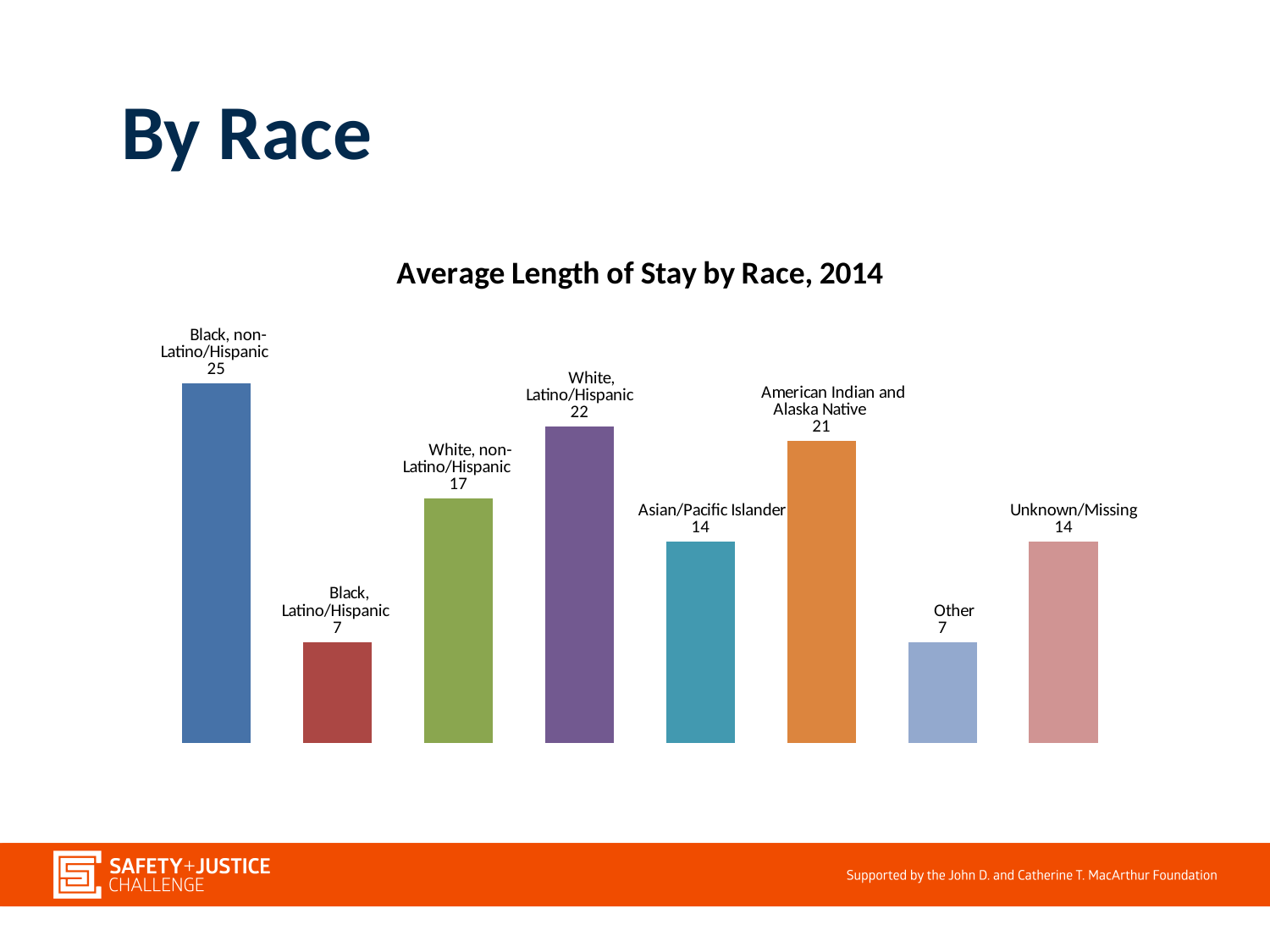
What is the title of the chart? Average Length of Stay by Race, 2014 Which category has the highest average length of stay? Black, non-Latino/Hispanic How many categories are shown in the chart? 8 What is the difference between the values for Black, non-Latino/Hispanic and Black, Latino/Hispanic? 18 What is the average length of stay for Black, non-Latino/Hispanic? 25 What is the average length of stay for American Indian and Alaska Native? 21 What is the lowest value shown in the chart? 7 What is the average length of stay for Asian/Pacific Islander? 14 What kind of chart is shown on the slide? Bar chart What is the difference between the values for White, Latino/Hispanic and White, non-Latino/Hispanic? 5 Which is larger, the value for White, non-Latino/Hispanic or the value for Unknown/Missing? White, non-Latino/Hispanic What is the average length of stay for White, Latino/Hispanic? 22